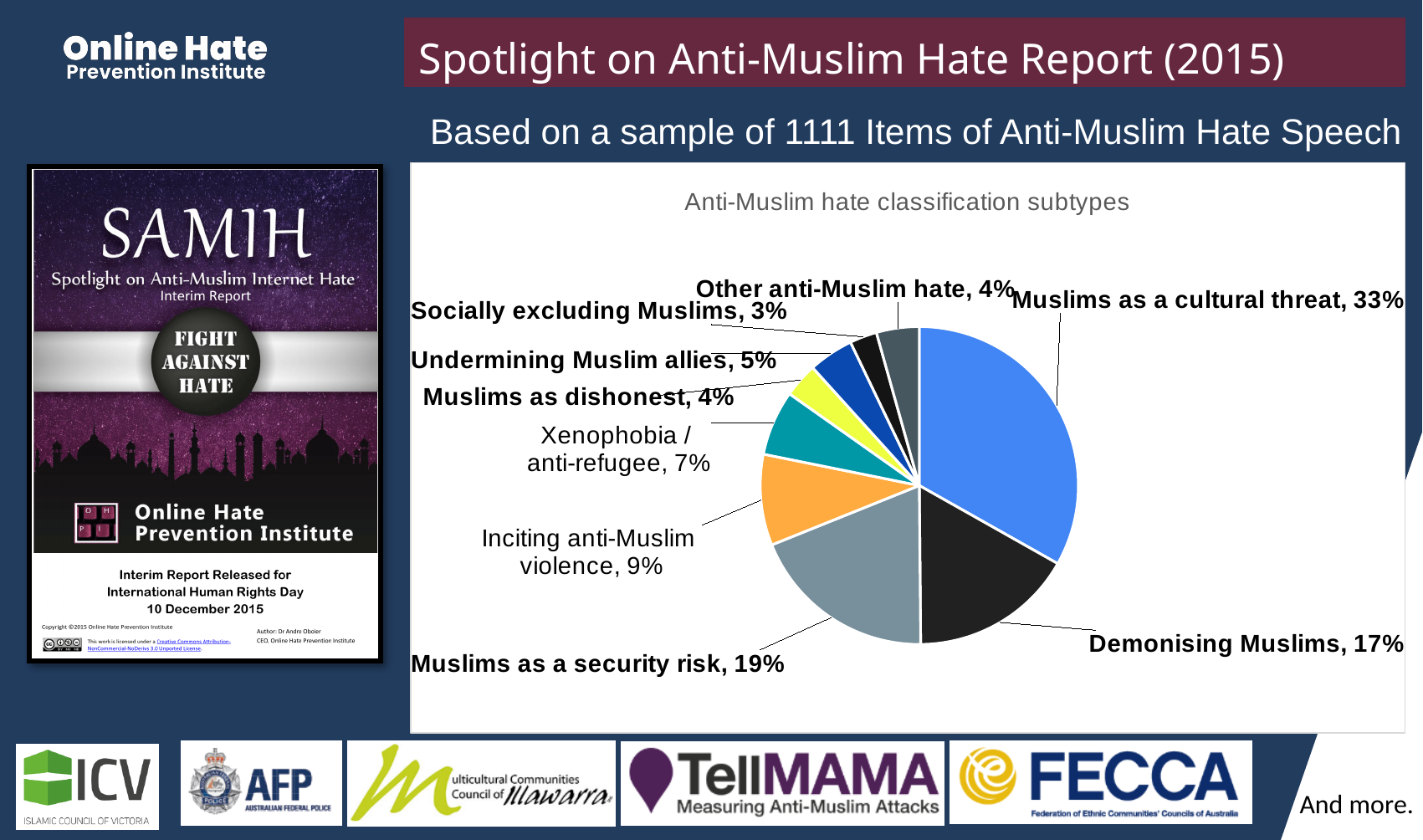
Which category has the largest slice of the pie? Muslims as a cultural threat What is the difference in percentage points between 'Muslims as a security risk' and 'Demonising Muslims'? 2 Which category has the smallest slice of the pie? Socially excluding Muslims What share of the pie is 'Muslims as a cultural threat'? 33% What kind of chart is shown on the slide? Pie chart What percentage is shown for 'Muslims as a security risk'? 19% What is the title of the chart? Anti-Muslim hate classification subtypes How many categories are shown in the pie chart? 9 What is the combined percentage of 'Muslims as a cultural threat' and 'Demonising Muslims'? 50% What percentage is shown for 'Inciting anti-Muslim violence'? 9% Which is larger, 'Undermining Muslim allies' or 'Muslims as dishonest'? Undermining Muslim allies What percentage is shown for 'Xenophobia / anti-refugee'? 7%